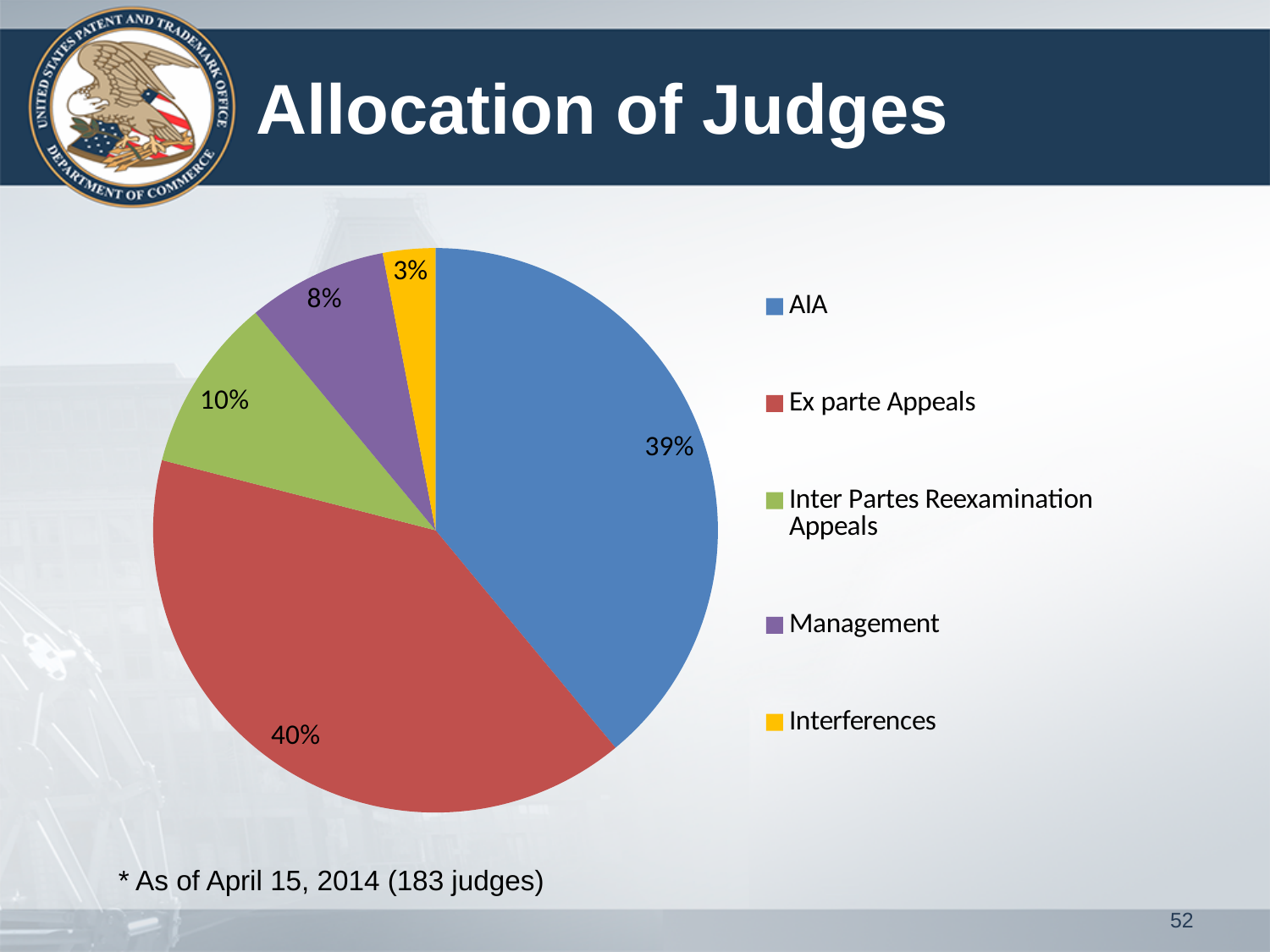
What share of judges is allocated to Management? 8% What share of judges is allocated to Ex parte Appeals? 40% What share of judges is allocated to Inter Partes Reexamination Appeals? 10% What is the title of the slide containing the chart? Allocation of Judges How many categories does the pie chart show? 5 What kind of chart is shown on the slide? Pie chart What share of judges is allocated to Interferences? 3% What share of judges is allocated to AIA? 39% Which category has the largest share of judges? Ex parte Appeals What is the difference in percentage points between the Ex parte Appeals share and the Management share? 32 Which is larger, the share for Inter Partes Reexamination Appeals or the share for Management? Inter Partes Reexamination Appeals Which category has the smallest share of judges? Interferences